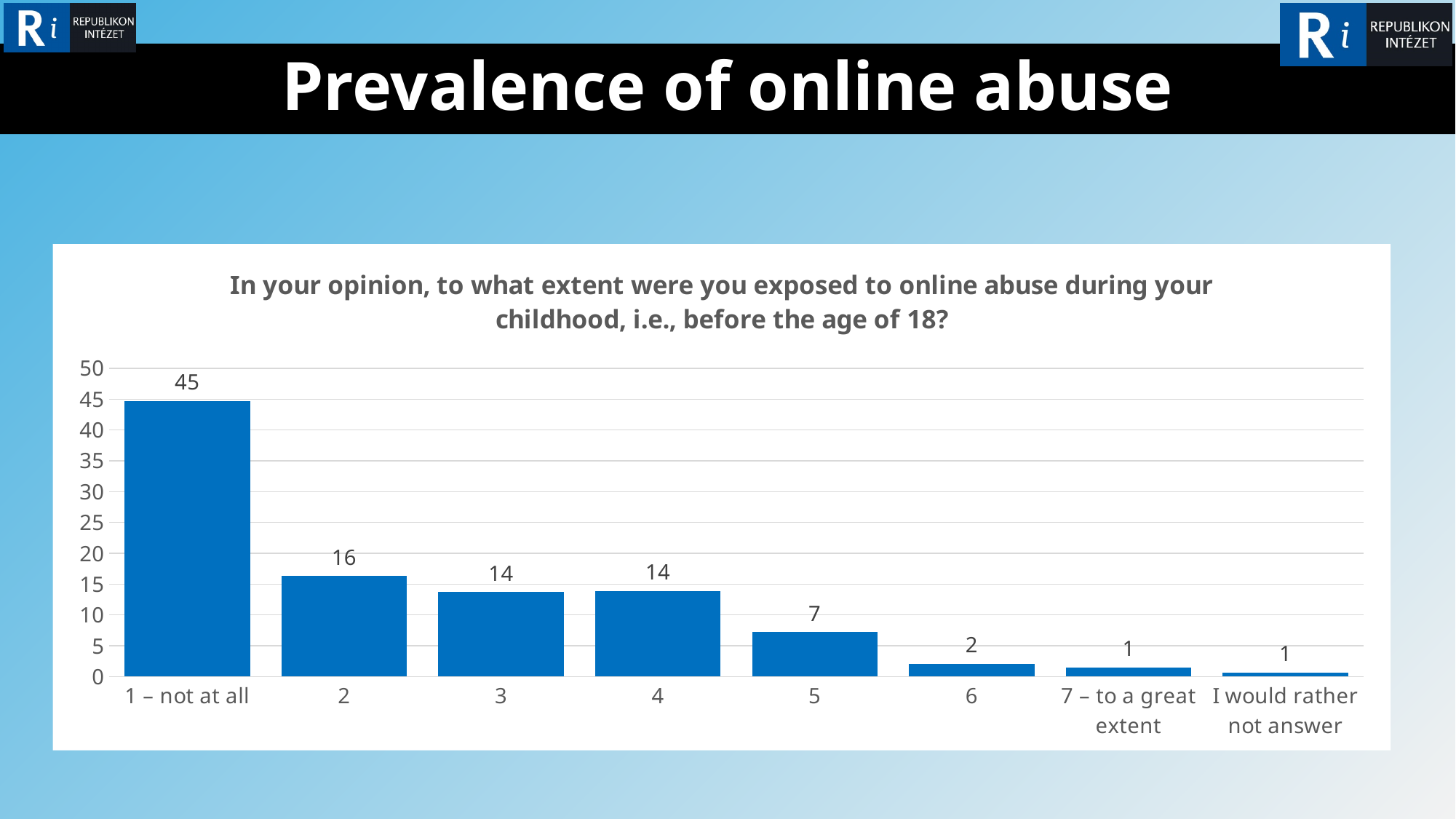
What is the difference between the values for category 5 and category 6? 5 What is the title of the chart? In your opinion, to what extent were you exposed to online abuse during your childhood, i.e., before the age of 18? Is the value for "1 – not at all" greater or less than 40? greater Which is larger, the value for category 2 or the value for category 3? 2 What is the value for "7 – to a great extent"? 1 What is the value for "I would rather not answer"? 1 Which category has the highest value? 1 – not at all What kind of chart is shown on the slide? bar chart What is the value for "1 – not at all"? 45 How many categories are shown on the x axis? 8 What is the value for category 5? 7 What is the difference between the values for "1 – not at all" and category 2? 29